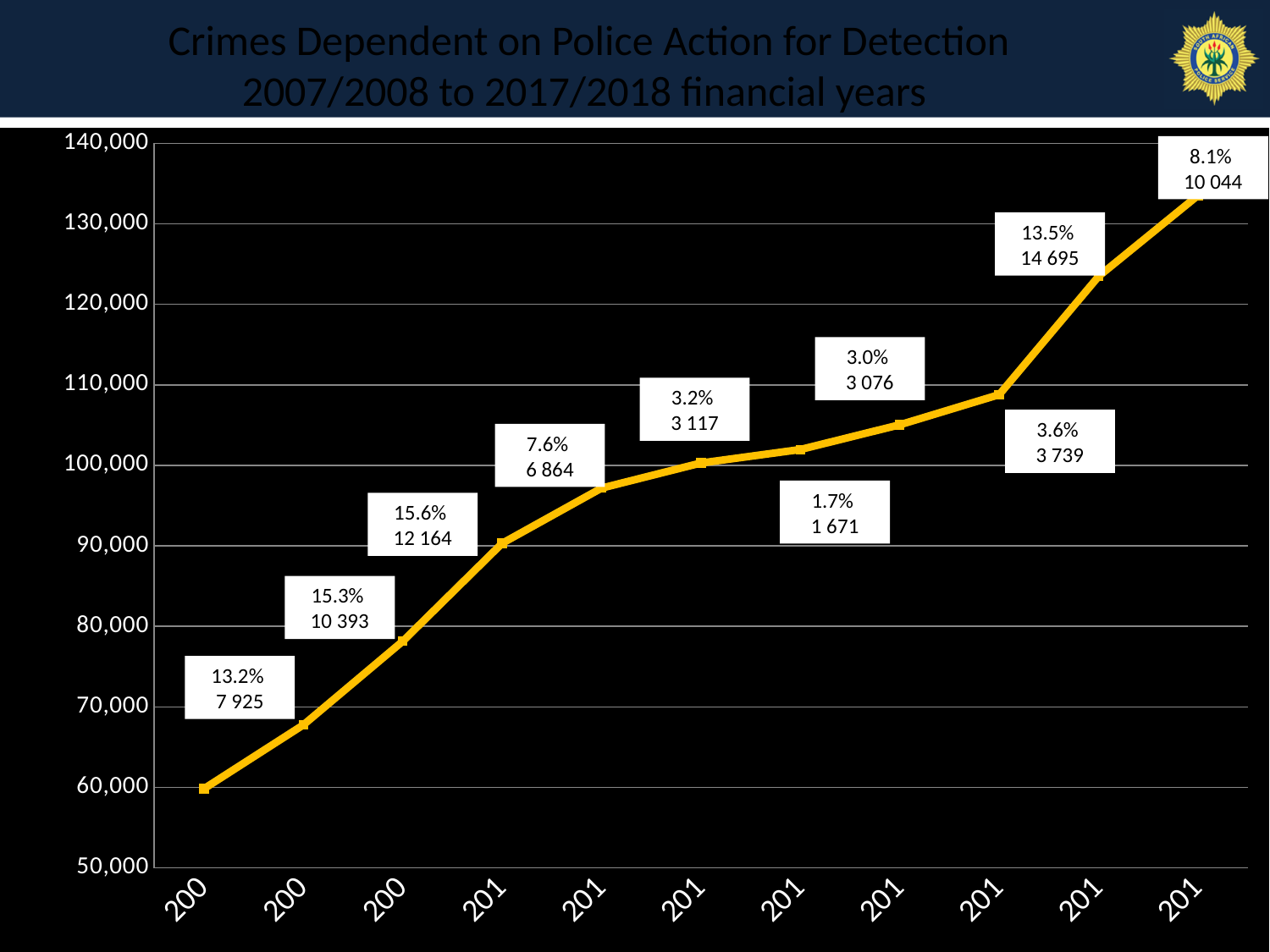
What is the highest percentage shown in the annotation boxes on the chart? 15.6% Do the plotted values rise or fall from left to right along the x axis? rise How many data points are plotted on the line? 11 What colour is the plotted line? yellow Is the value of the last (rightmost) point greater or less than 130,000? greater Which is larger, the first point or the last point on the line? the last point Is the value of the fourth point from the left greater or less than 100,000? less Is the value of the first (leftmost) point greater or less than 70,000? less What is the largest absolute change figure shown in the annotation boxes? 14 695 What is the lowest percentage shown in the annotation boxes on the chart? 1.7% What kind of chart is shown on the slide? line chart What is the title of the chart? Crimes Dependent on Police Action for Detection 2007/2008 to 2017/2018 financial years